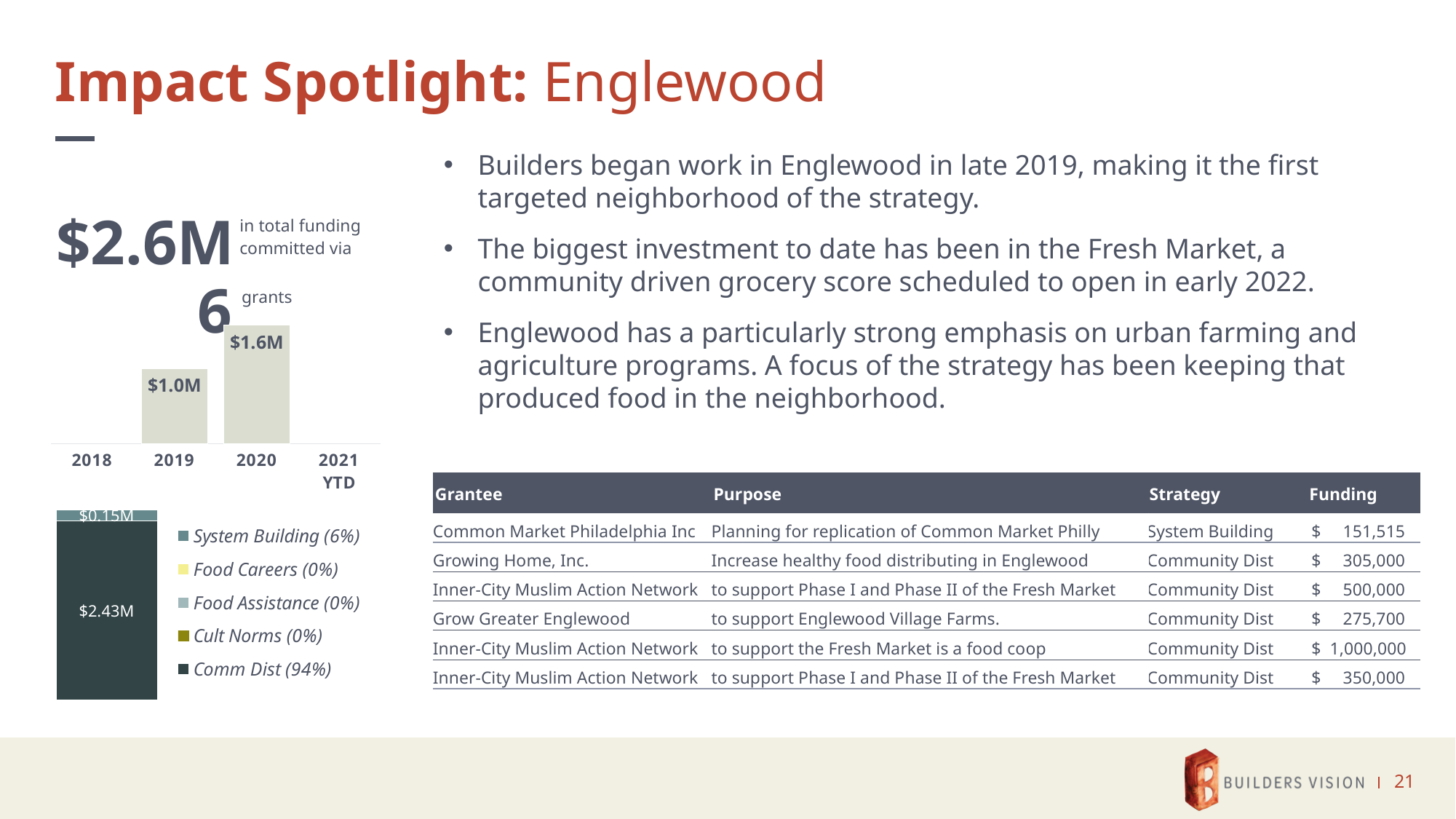
In the stacked bar chart at the bottom left, what percentage share does the legend give for Comm Dist? 94% In the bar chart by year, how many year categories are shown on the x axis? 4 In the bar chart by year, what is the value for 2020? $1.6M In the stacked bar chart at the bottom left, how many entries does the legend list? 5 In the bar chart by year, which year has the highest value? 2020 In the bar chart by year, what is the value for 2019? $1.0M In the bar chart by year, is the value for 2020 larger or smaller than the value for 2019? larger What kind of chart is the chart showing funding by year? bar chart In the stacked bar chart at the bottom left, which legend entry has the largest share? Comm Dist (94%) In the stacked bar chart at the bottom left, what is the value of the System Building segment? $0.15M In the stacked bar chart at the bottom left, what is the value of the Comm Dist segment? $2.43M In the bar chart by year, what is the difference between the 2020 and 2019 values? $0.6M